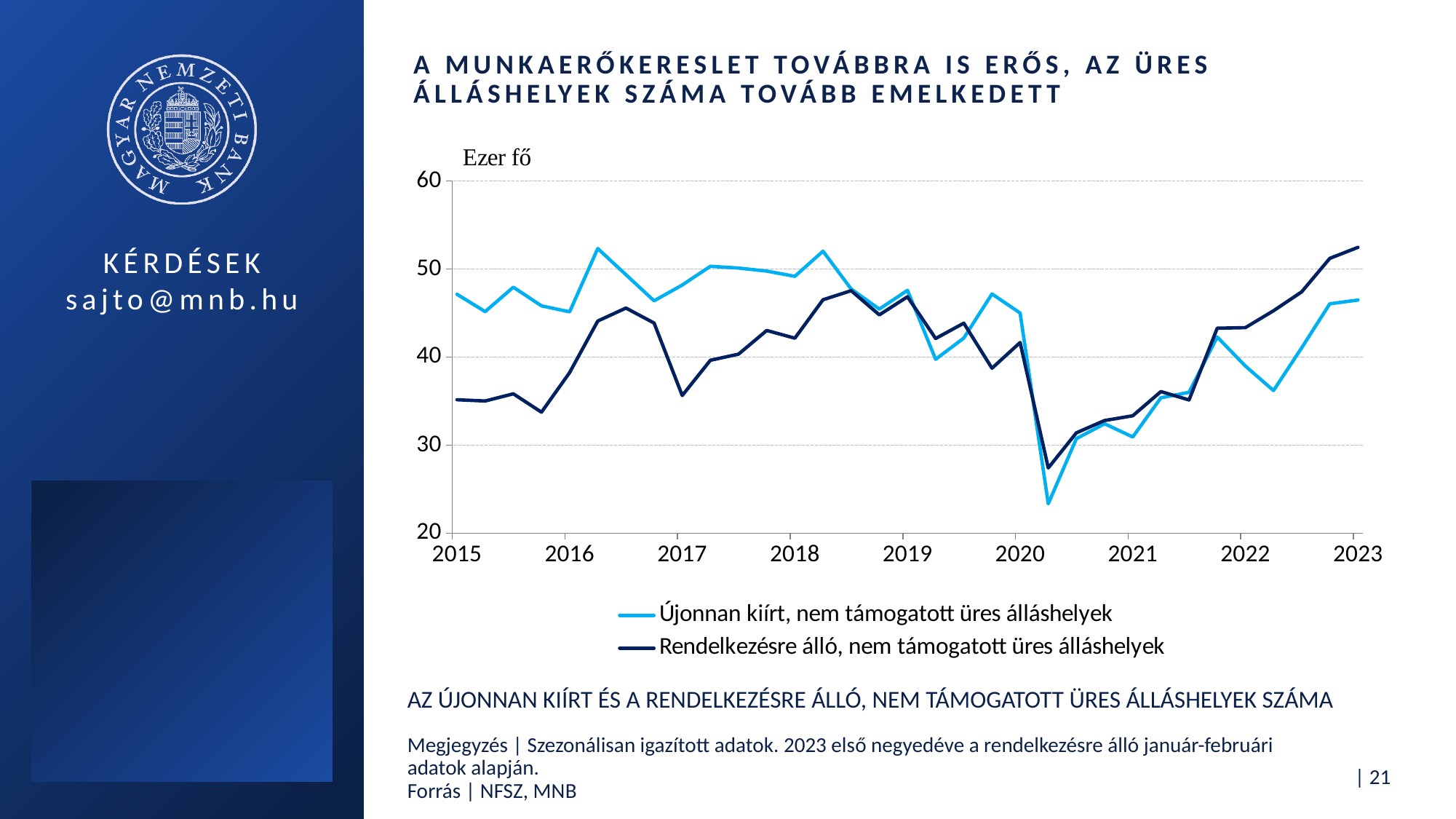
At 2023, which series has the higher value? Rendelkezésre álló, nem támogatott üres álláshelyek How many series does the legend list? 2 At 2015, which series has the higher value? Újonnan kiírt, nem támogatott üres álláshelyek Is the value for 'Rendelkezésre álló, nem támogatott üres álláshelyek' at 2015 greater or less than 40? less Does the 'Rendelkezésre álló, nem támogatott üres álláshelyek' series rise or fall between 2021 and 2023? rise What is the title of the chart shown below the legend? AZ ÚJONNAN KIÍRT ÉS A RENDELKEZÉSRE ÁLLÓ, NEM TÁMOGATOTT ÜRES ÁLLÁSHELYEK SZÁMA Is the lowest value of 'Újonnan kiírt, nem támogatott üres álláshelyek' in 2020 greater or less than 30? less Is the value for 'Újonnan kiírt, nem támogatott üres álláshelyek' at 2015 greater or less than 40? greater What unit is shown above the vertical axis of the chart? Ezer fő What kind of chart is shown on the slide? line chart